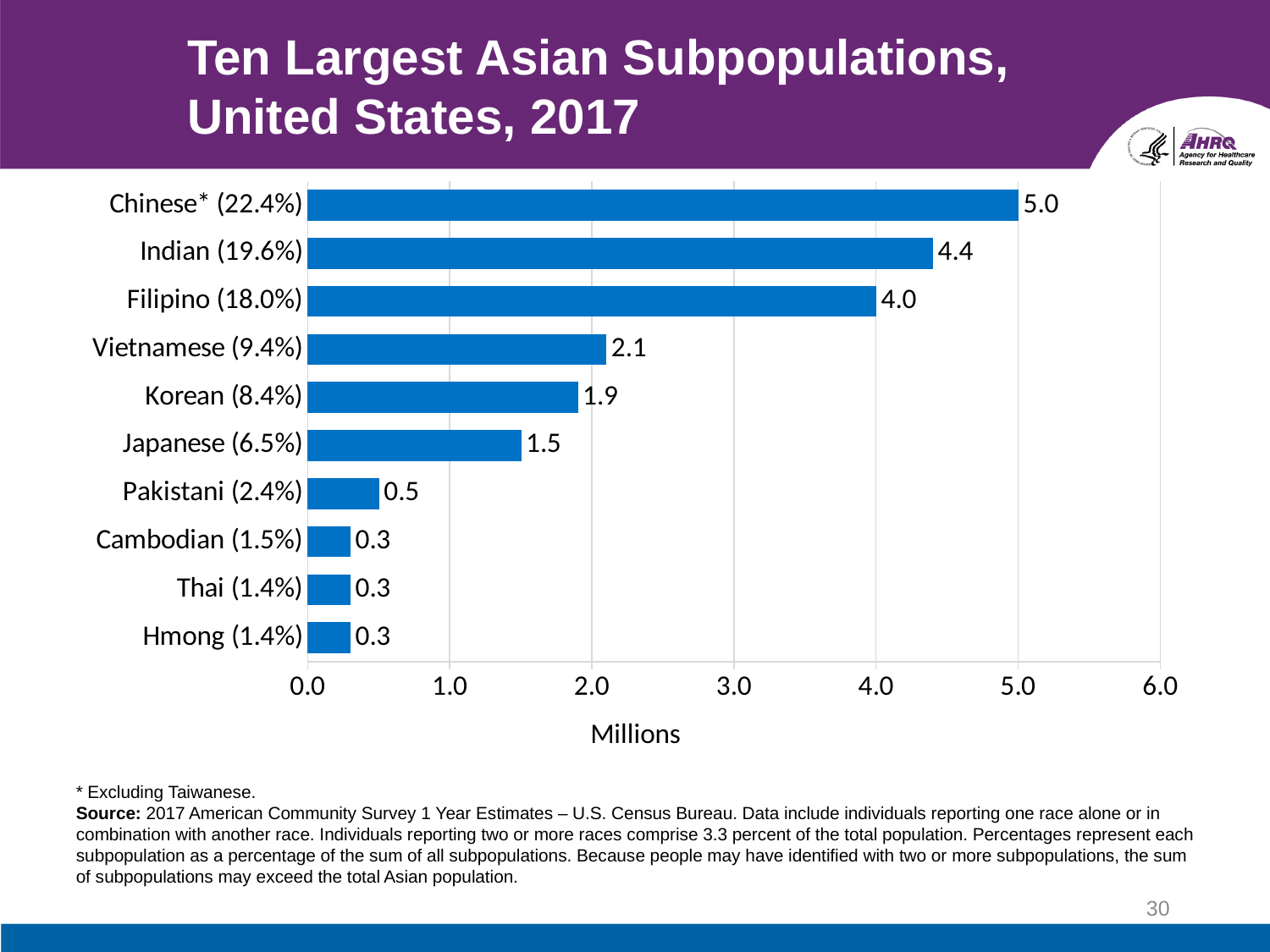
How many subpopulations are shown in the chart? 10 Is the value for Filipino (18.0%) greater or less than 3.0? greater Which is larger, the value for Korean (8.4%) or the value for Japanese (6.5%)? Korean (8.4%) Which subpopulation has the highest value? Chinese* (22.4%) What is the difference between the values for Indian (19.6%) and Filipino (18.0%)? 0.4 What is the label of the horizontal axis? Millions What kind of chart is shown on the slide? bar chart What is the value for Pakistani (2.4%)? 0.5 What is the value for Vietnamese (9.4%)? 2.1 What is the value for Chinese* (22.4%)? 5.0 What is the difference between the values for Chinese* (22.4%) and Japanese (6.5%)? 3.5 What is the title of the chart? Ten Largest Asian Subpopulations, United States, 2017